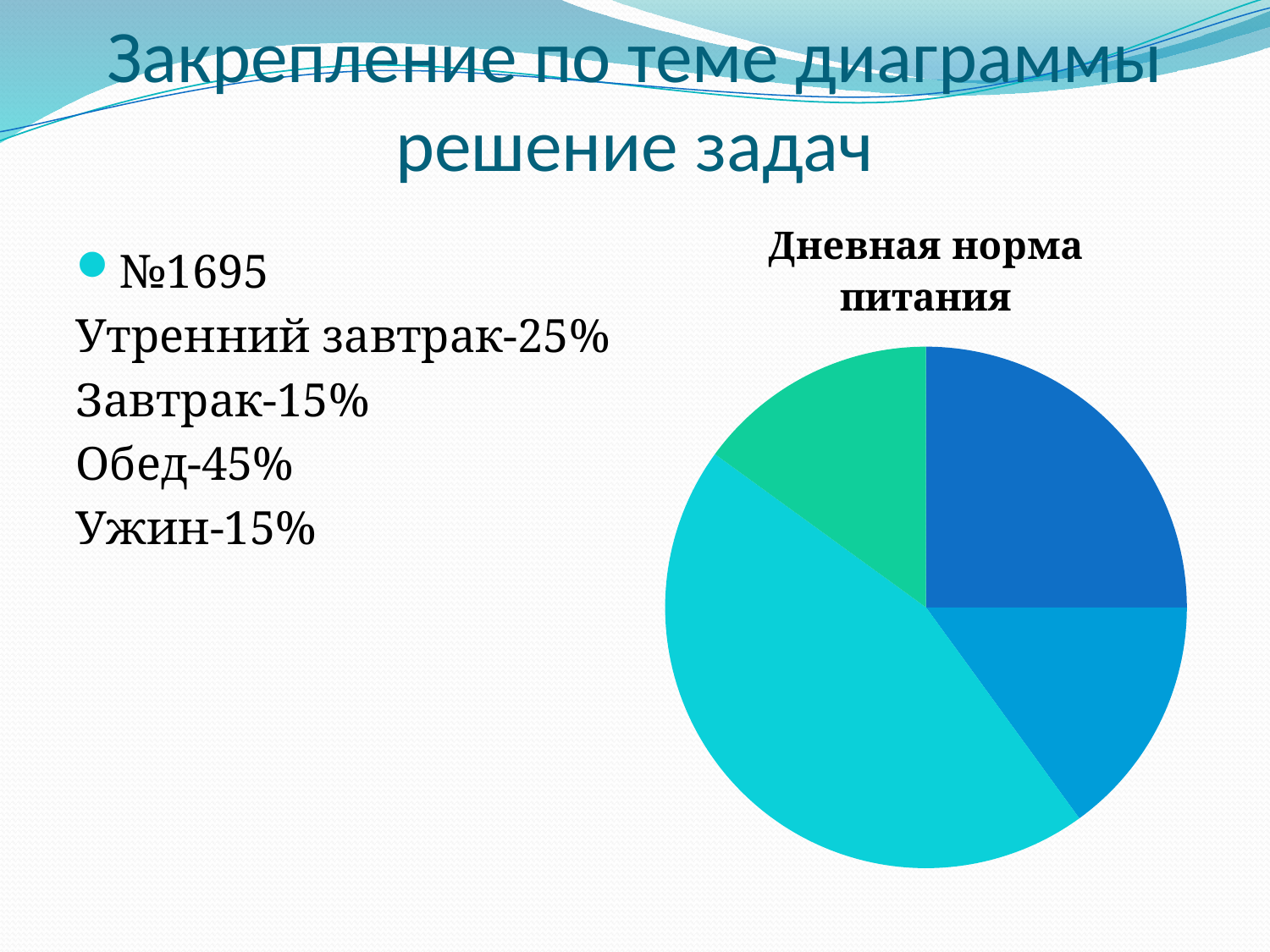
According to the slide, what share of the daily diet is Ужин? 15% What is the difference between the share for Обед and the share for Утренний завтрак? 20% What kind of chart is shown on the slide? pie chart According to the slide, what share of the daily diet is Обед? 45% Which meal has the largest share of the daily diet? Обед Does the largest slice of the pie take up more or less than half of the pie? less What is the total of the four shares listed on the slide? 100% Which is larger, the share for Обед or the share for Завтрак? Обед According to the slide, what share of the daily diet is Утренний завтрак? 25% Does the pie chart have a legend? No What is the title of the pie chart? Дневная норма питания How many slices does the pie chart have? 4